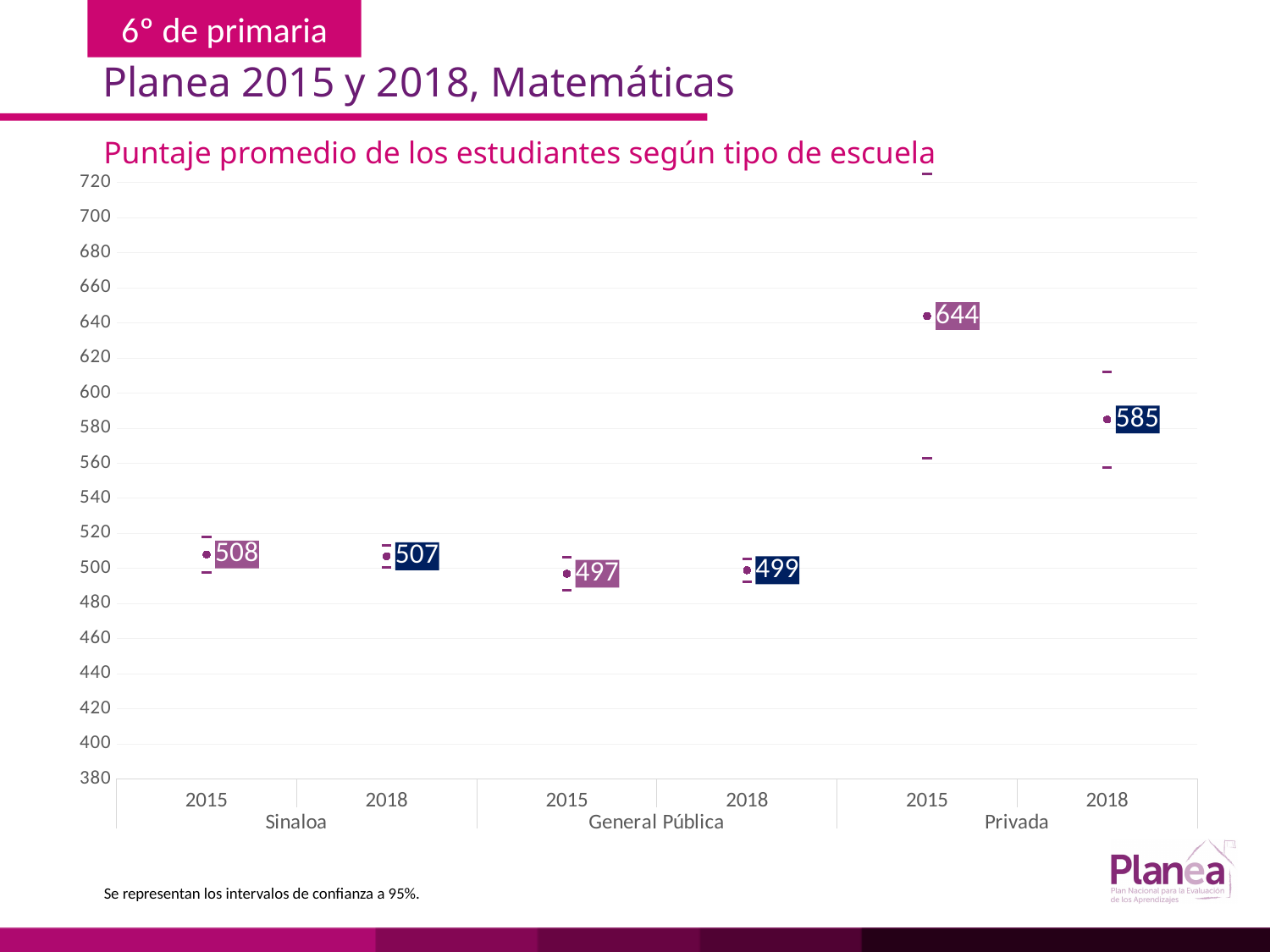
How many data points are plotted on the chart? 6 What is the average score for General Pública schools in 2015? 497 What is the average score for Sinaloa in 2018? 507 What is the title of the chart? Puntaje promedio de los estudiantes según tipo de escuela Which is larger, the General Pública score in 2015 or in 2018? 2018 What is the difference between the Sinaloa 2018 score and the General Pública 2018 score? 8 What is the average score for Privada schools in 2015? 644 By how many points did the Privada average score fall from 2015 to 2018? 59 What is the average score for Sinaloa in 2015? 508 Which school type and year has the lowest average score? General Pública 2015 What is the average score for Privada schools in 2018? 585 Which school type and year has the highest average score? Privada 2015